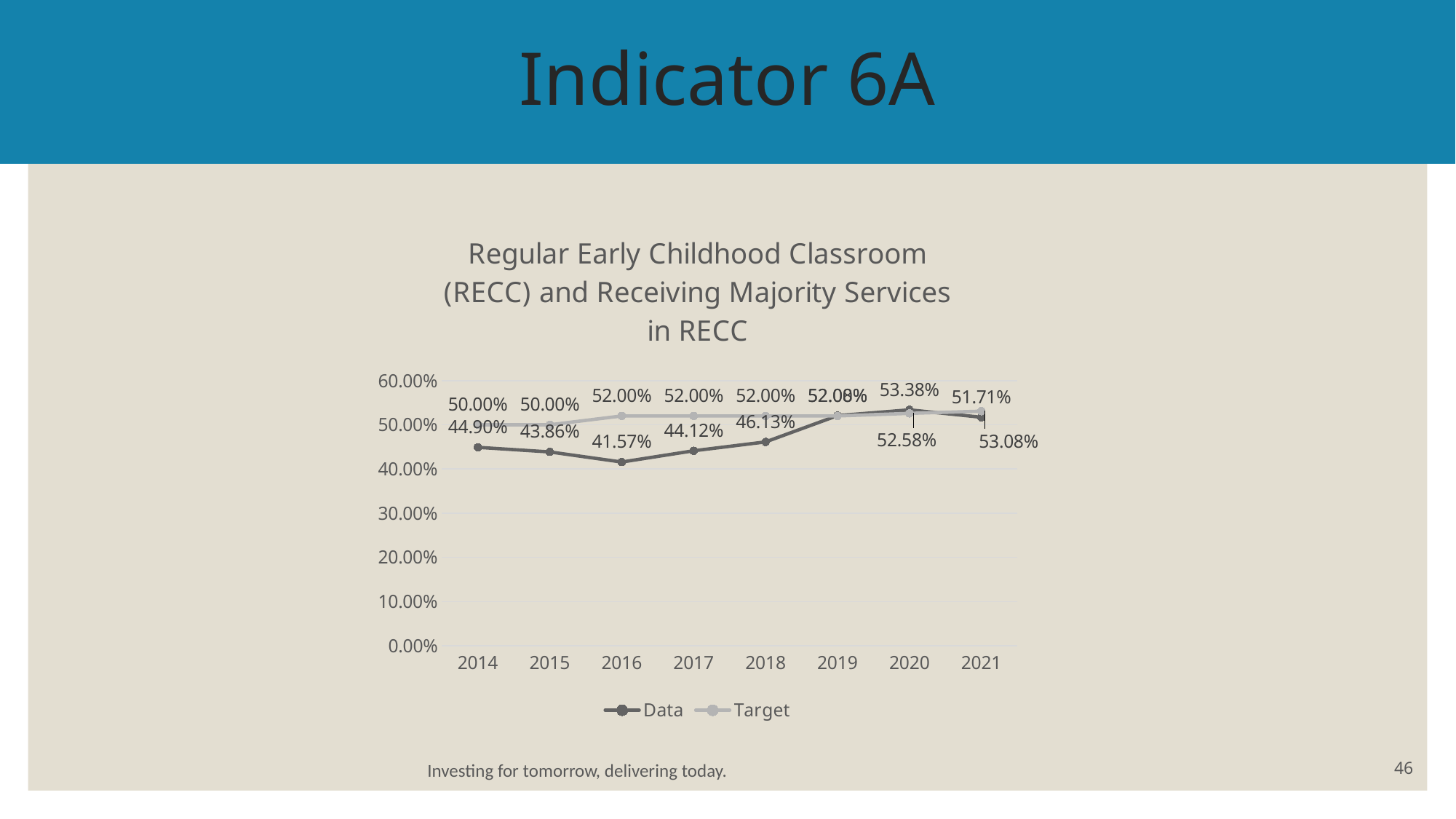
In which year is the Data series lowest? 2016 How many series does the legend list? 2 What is the Data value for 2016? 41.57% What is the Data value for 2014? 44.90% What is the Target value for 2021? 53.08% Does the Data series rise or fall from 2014 to 2016? Fall What kind of chart is shown on the slide? Line chart In 2021, which is larger, the Data value or the Target value? Target What is the Data value for 2020? 53.38% How many years are shown on the x axis? 8 What is the difference between the Data values for 2018 and 2017? 2.01% In which year is the Data series highest? 2020